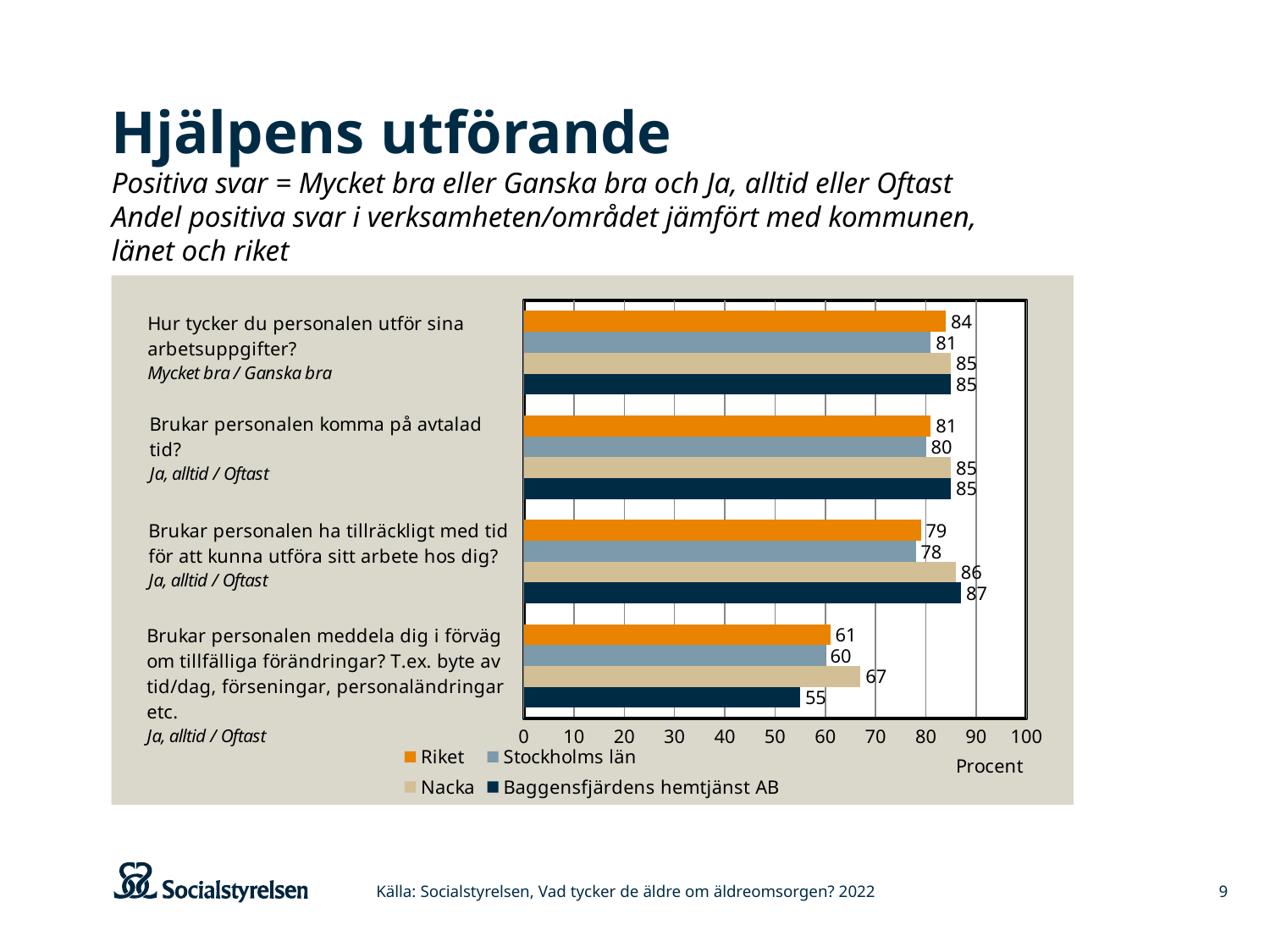
What is the value for Stockholms län on the question "Brukar personalen komma på avtalad tid?"? 80 Which series has the highest value on the question "Brukar personalen ha tillräckligt med tid för att kunna utföra sitt arbete hos dig?"? Baggensfjärdens hemtjänst AB What is the label on the horizontal axis of the chart? Procent What is the value for Baggensfjärdens hemtjänst AB on the question "Brukar personalen meddela dig i förväg om tillfälliga förändringar?"? 55 Which series has the lowest value on the question "Brukar personalen meddela dig i förväg om tillfälliga förändringar?"? Baggensfjärdens hemtjänst AB How many series does the legend list? 4 What is the difference between Nacka and Baggensfjärdens hemtjänst AB on the question "Brukar personalen meddela dig i förväg om tillfälliga förändringar?"? 12 What is the value for Nacka on the question "Brukar personalen ha tillräckligt med tid för att kunna utföra sitt arbete hos dig?"? 86 What is the value for Riket on the question "Hur tycker du personalen utför sina arbetsuppgifter?"? 84 Which is larger on the question "Brukar personalen komma på avtalad tid?": Riket or Nacka? Nacka How many question categories are shown on the chart? 4 What kind of chart is shown on the slide? Bar chart